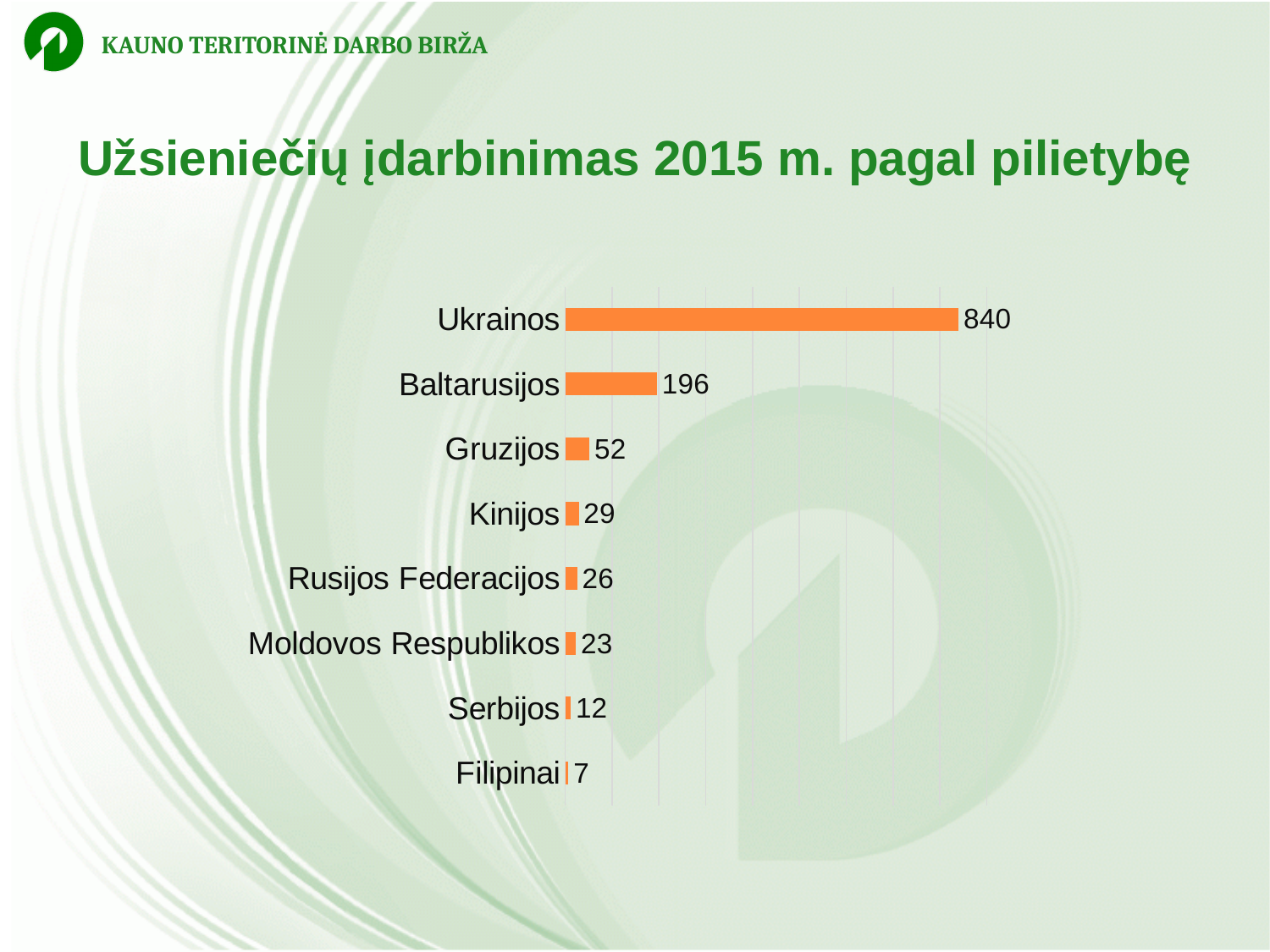
What is the value for Baltarusijos? 196 Which category has the lowest value? Filipinai What is the value for Gruzijos? 52 What is the value for Filipinai? 7 What is the value for Rusijos Federacijos? 26 Which category has the highest value? Ukrainos What kind of chart is shown on the slide? Bar chart What is the value for Ukrainos? 840 What is the difference between the values for Kinijos and Moldovos Respublikos? 6 How many categories are shown in the chart? 8 What is the difference between the values for Ukrainos and Baltarusijos? 644 Which is larger, the value for Gruzijos or the value for Serbijos? Gruzijos